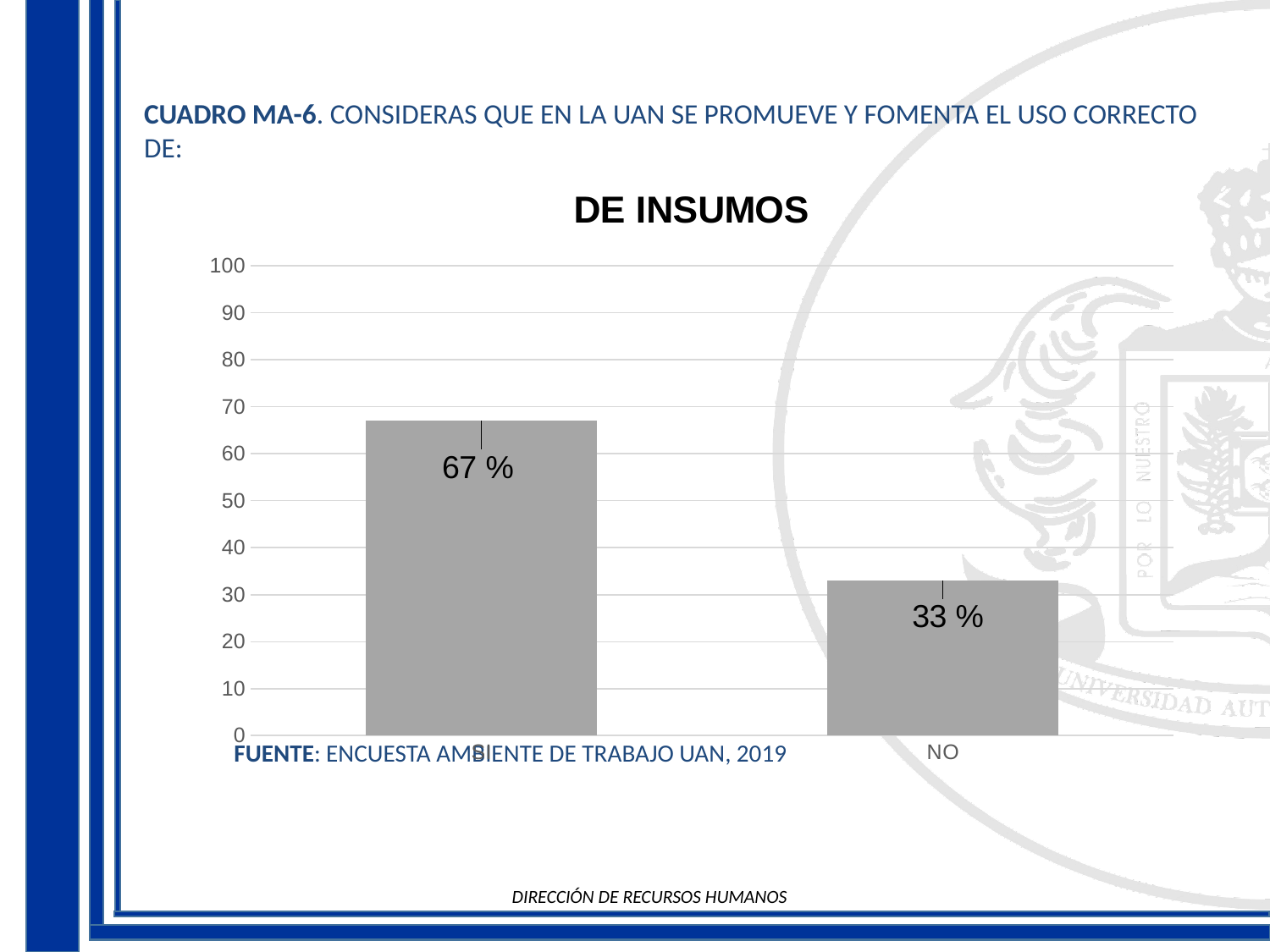
Which category has the lowest value? NO What is the title of the chart? DE INSUMOS Is the value for NO greater or less than 40? less Which is larger, the value for SI or the value for NO? SI How many bars are plotted in the chart? 2 Is the value for SI greater or less than 60? greater What type of chart is shown on the slide? bar chart What is the value shown for the NO bar? 33 % What is the maximum value shown on the vertical axis? 100 Which category has the highest value? SI What is the value shown for the left bar (SI)? 67 % What is the difference between the SI value and the NO value? 34 %